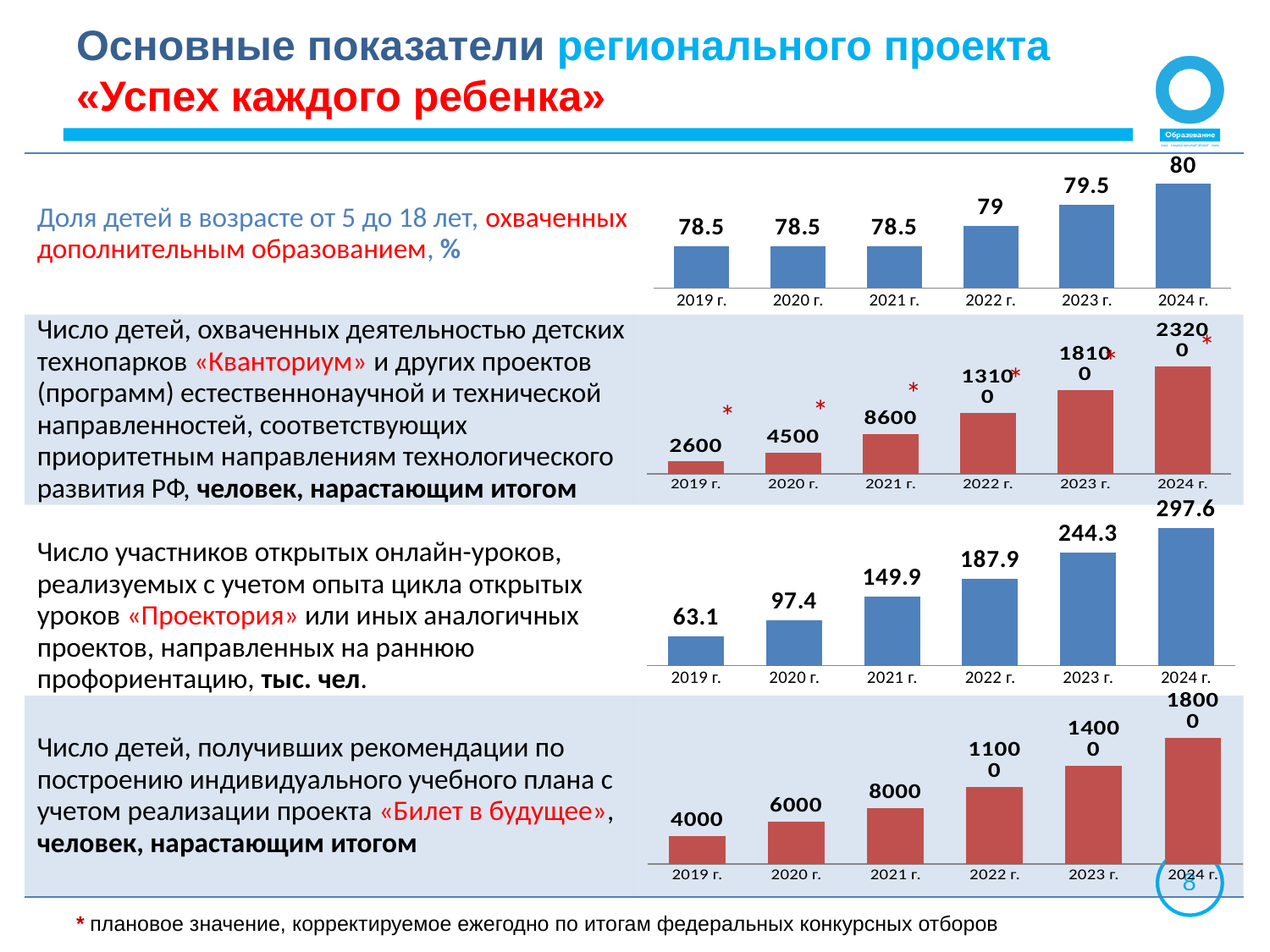
In the bottom chart (children who received recommendations under «Билет в будущее»), what is the value for 2021 г.? 8000 In the top chart (share of children covered by additional education, %), what is the difference between the 2024 г. and 2019 г. values? 1.5 In the third chart from the top (participants of «Проектория» online lessons, тыс. чел.), what is the value for 2023 г.? 244.3 In the second chart from the top (children covered by «Кванториум» technoparks), what is the value for 2021 г.? 8600 In the second chart from the top (children covered by «Кванториум» technoparks), what is the difference between the 2020 г. and 2019 г. values? 1900 In the bottom chart (children who received recommendations under «Билет в будущее»), which is larger: the value for 2020 г. or the value for 2022 г.? 2022 г. How many years (categories) are shown on the x axis of the bottom chart (children who received recommendations under «Билет в будущее»)? 6 In the third chart from the top (participants of «Проектория» online lessons, тыс. чел.), which year has the highest value? 2024 г. In the second chart from the top (children covered by «Кванториум» technoparks), which year has the lowest value? 2019 г. In the top chart (share of children aged 5 to 18 covered by additional education, %), what is the value for 2024 г.? 80 In the top chart (share of children aged 5 to 18 covered by additional education, %), what is the value for 2022 г.? 79 In the third chart from the top (participants of «Проектория» online lessons), do the values rise or fall from 2019 г. to 2024 г.? rise